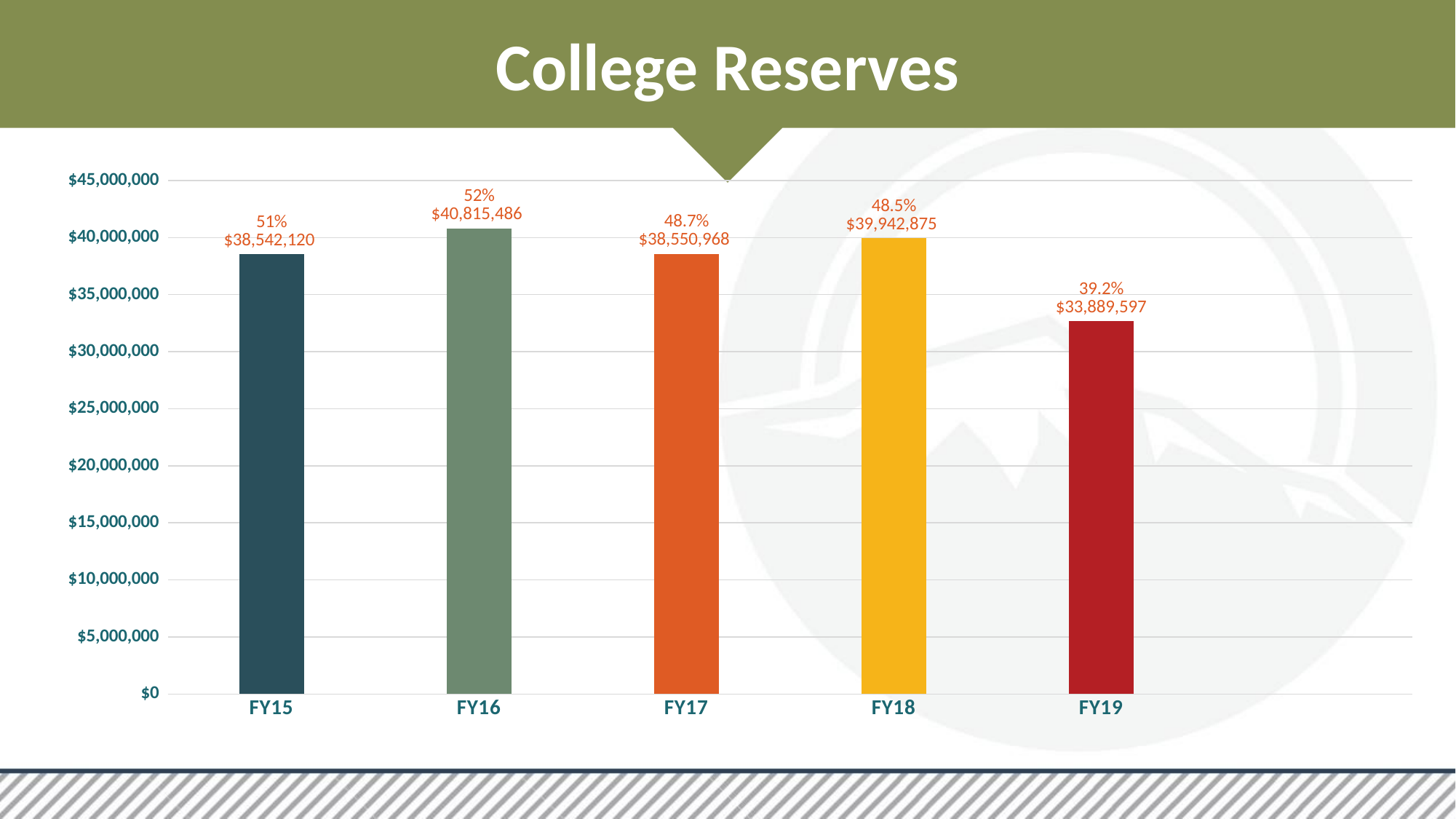
Which is larger, the reserve value for FY16 or for FY18? FY16 What is the title of the chart? College Reserves What percentage is shown above the FY15 bar? 51% Which fiscal year has the highest college reserves? FY16 What kind of chart is shown on the slide? bar chart Which fiscal year has the lowest college reserves? FY19 How many fiscal years are shown on the chart? 5 What is the dollar value shown for FY16? $40,815,486 What is the dollar value shown for FY18? $39,942,875 What is the difference between the FY16 and FY19 reserve values? $6,925,889 What percentage is shown above the FY19 bar? 39.2% Is the value for FY19 greater or less than $35,000,000? less